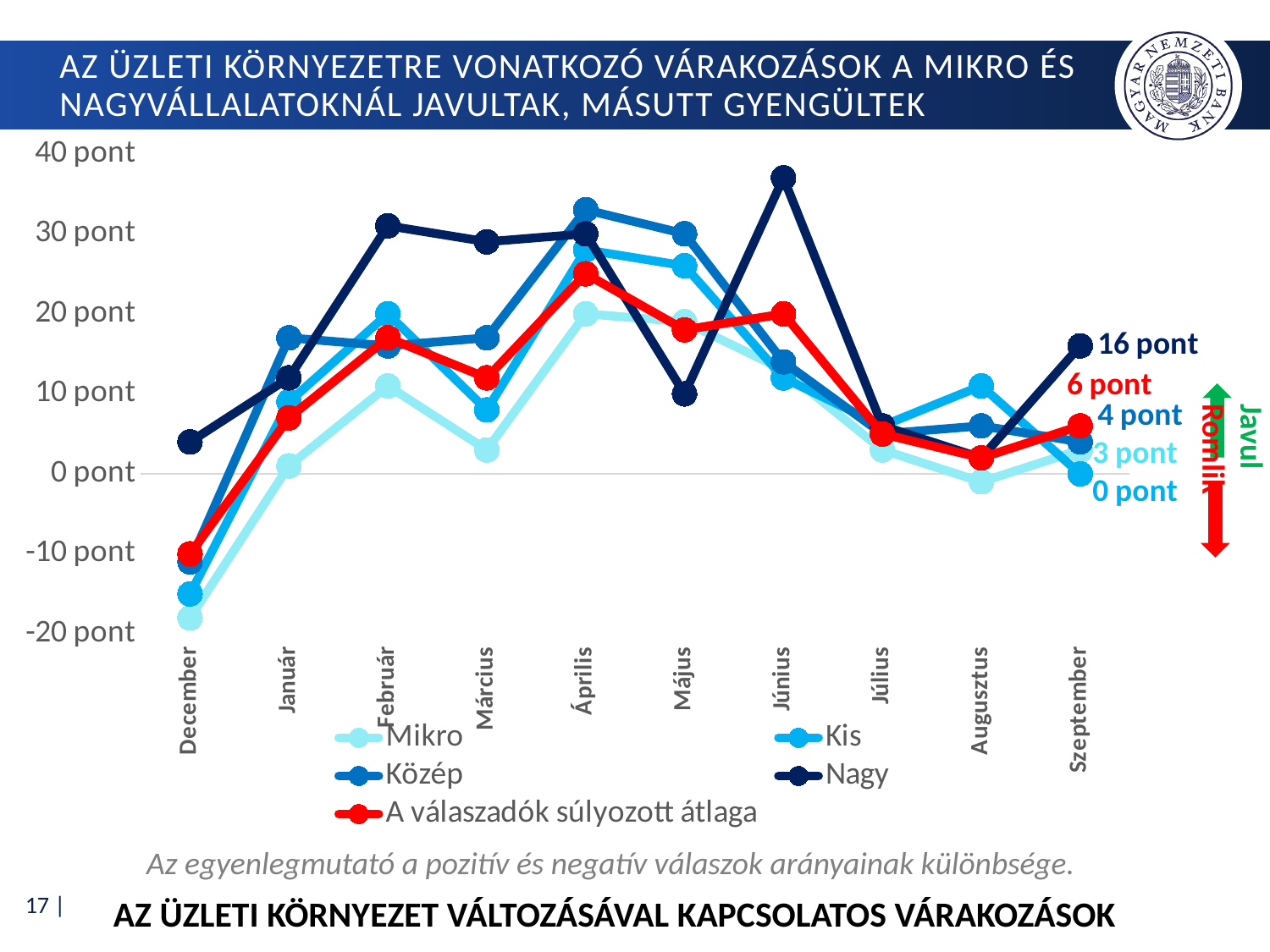
Is the value for Nagy in Június greater or less than 30 pont? greater Which is larger in Szeptember, Nagy or Közép? Nagy What is the value for Közép in Szeptember? 4 pont What kind of chart is shown on the slide? line chart Which legend entry is drawn in red? A válaszadók súlyozott átlaga How many series does the legend list? 5 How many months are shown on the x axis? 10 Is the value for Mikro in December greater or less than -10 pont? less Which series has the highest value in Szeptember? Nagy What is the difference between Nagy and Közép in Szeptember? 12 pont What is the value for Nagy in Szeptember? 16 pont What is the value for A válaszadók súlyozott átlaga in Szeptember? 6 pont